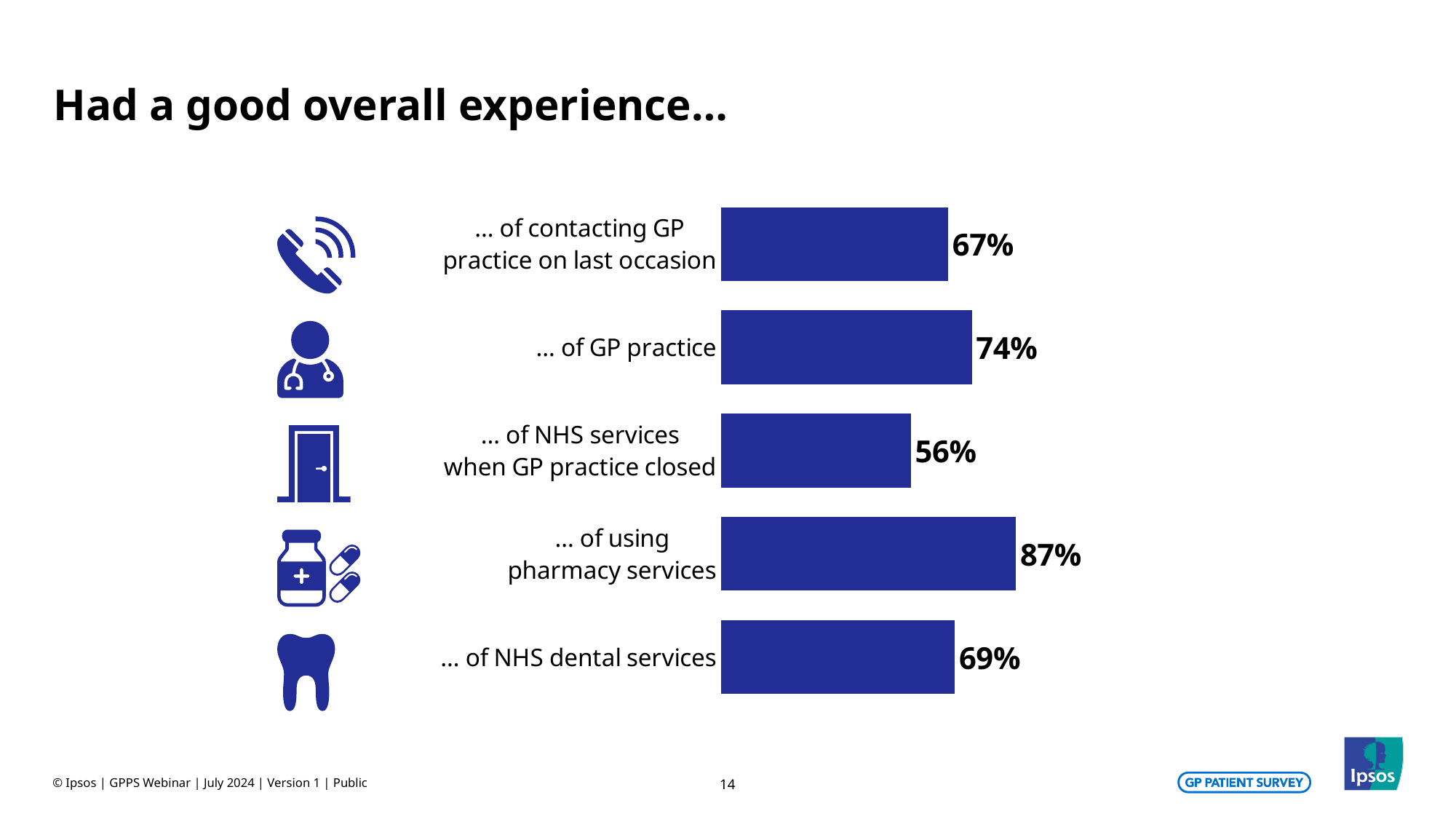
What percentage had a good overall experience of NHS dental services? 69% What percentage had a good overall experience of contacting their GP practice on the last occasion? 67% Which category has the lowest percentage reporting a good overall experience? ... of NHS services when GP practice closed What is the difference in percentage points between the pharmacy services value and the NHS services when GP practice closed value? 31 Which is larger: the value for GP practice or the value for NHS dental services? ... of GP practice What kind of chart is shown on the slide? Bar chart What is the title of the slide? Had a good overall experience... How many categories are shown in the chart? 5 What percentage had a good overall experience of their GP practice? 74% Which category has the highest percentage reporting a good overall experience? ... of using pharmacy services What percentage had a good overall experience of NHS services when the GP practice was closed? 56% What percentage had a good overall experience of using pharmacy services? 87%